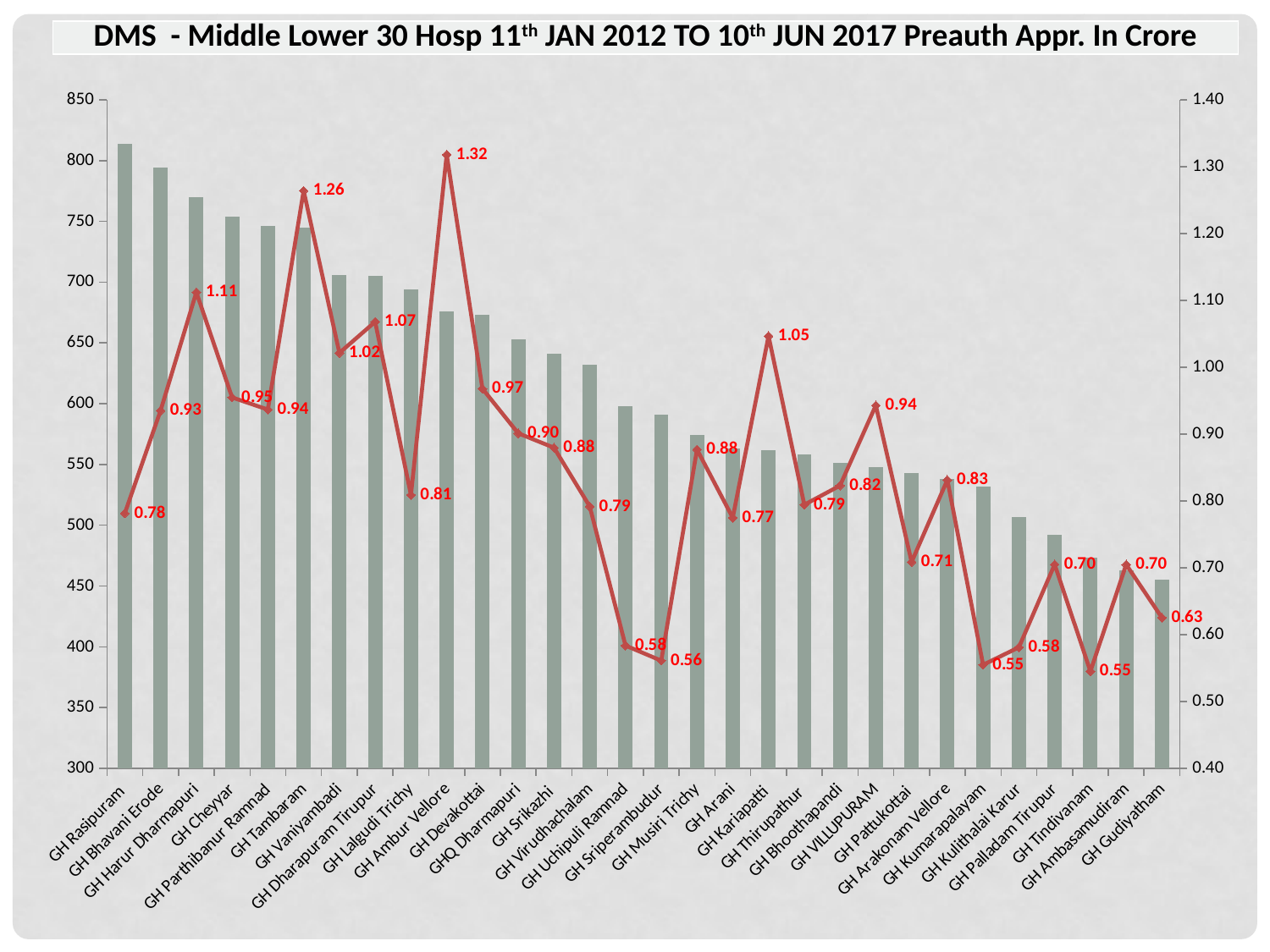
Is the bar value for GH Gudiyatham greater or less than 500? less Which hospital has the highest line value? GH Ambur Vellore What is the line value for GH Kariapatti? 1.05 How many hospitals are shown on the x axis? 30 What is the line value for GH Ambur Vellore? 1.32 What is the difference between the line values for GH Ambur Vellore and GH Tambaram? 0.06 Which hospital has the tallest bar? GH Rasipuram Which has the larger line value, GH Harur Dharmapuri or GH Dharapuram Tirupur? GH Harur Dharmapuri Is the bar value for GH Rasipuram greater or less than 800? greater What is the line value for GH Tambaram? 1.26 Which hospital has the shortest bar? GH Gudiyatham What is the line value for GH Gudiyatham? 0.63